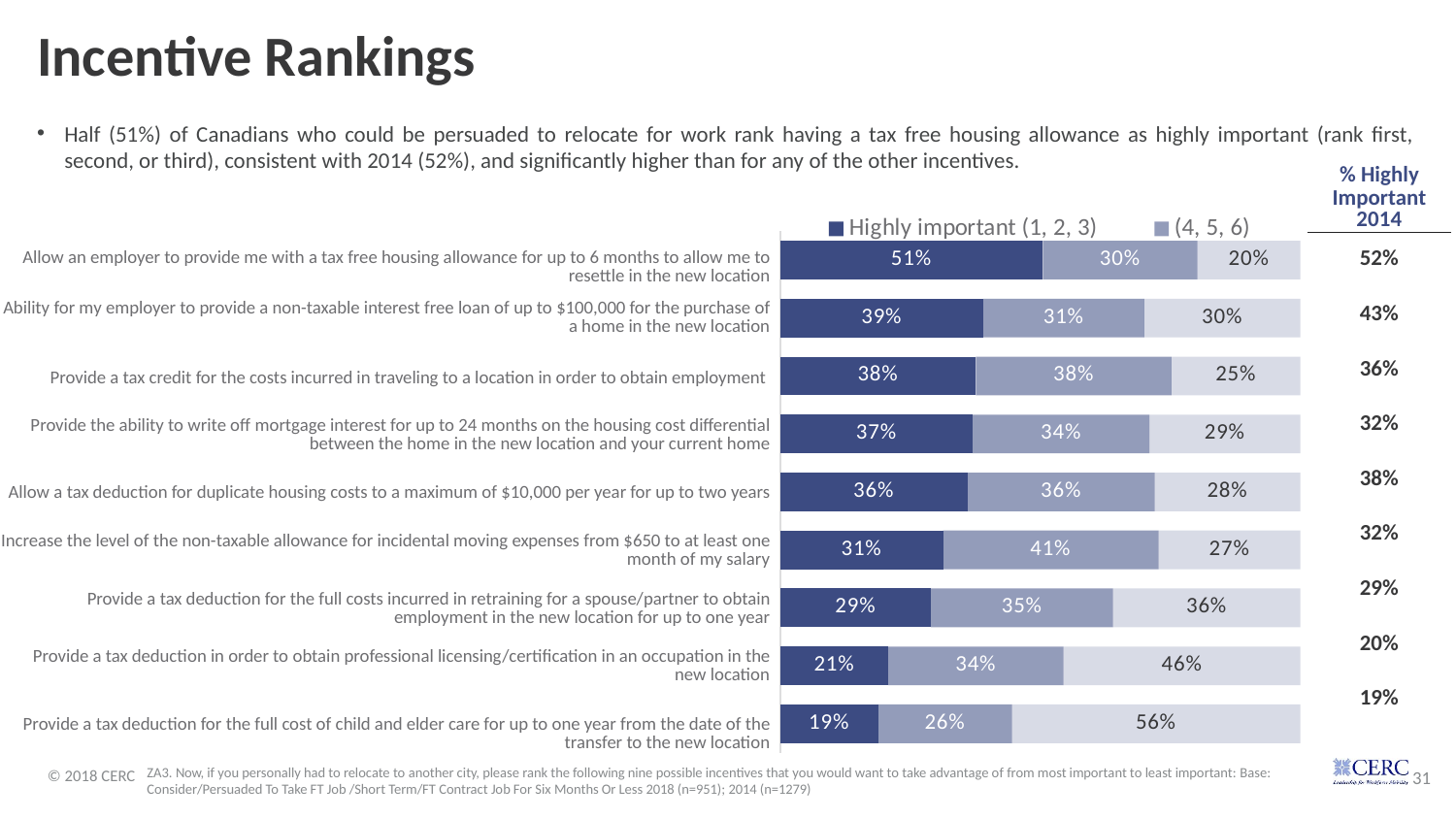
What is the light grey (lowest-ranked) segment value for the tax deduction for professional licensing/certification? 46% What kind of chart is shown on the slide? Stacked bar chart What is the (4, 5, 6) value for the incentive to increase the non-taxable allowance for incidental moving expenses? 41% What is the % Highly Important 2014 value for the non-taxable interest free loan of up to $100,000? 43% What is the difference in 'Highly important (1, 2, 3)' percentage between the tax free housing allowance (51%) and the non-taxable interest free loan (39%)? 12 percentage points What is the label of the first legend entry in the chart? Highly important (1, 2, 3) For the tax deduction for duplicate housing costs, which is larger: the 2018 'Highly important' value or the 2014 value? The 2014 value (38%) How many series does the chart legend list? 2 How many incentives (categories) are plotted in the chart? 9 Which incentive has the lowest 'Highly important (1, 2, 3)' percentage? Provide a tax deduction for the full cost of child and elder care for up to one year What percentage rank the tax free housing allowance for up to 6 months as highly important (1, 2, 3)? 51% Which incentive has the highest 'Highly important (1, 2, 3)' percentage? Allow an employer to provide me with a tax free housing allowance for up to 6 months